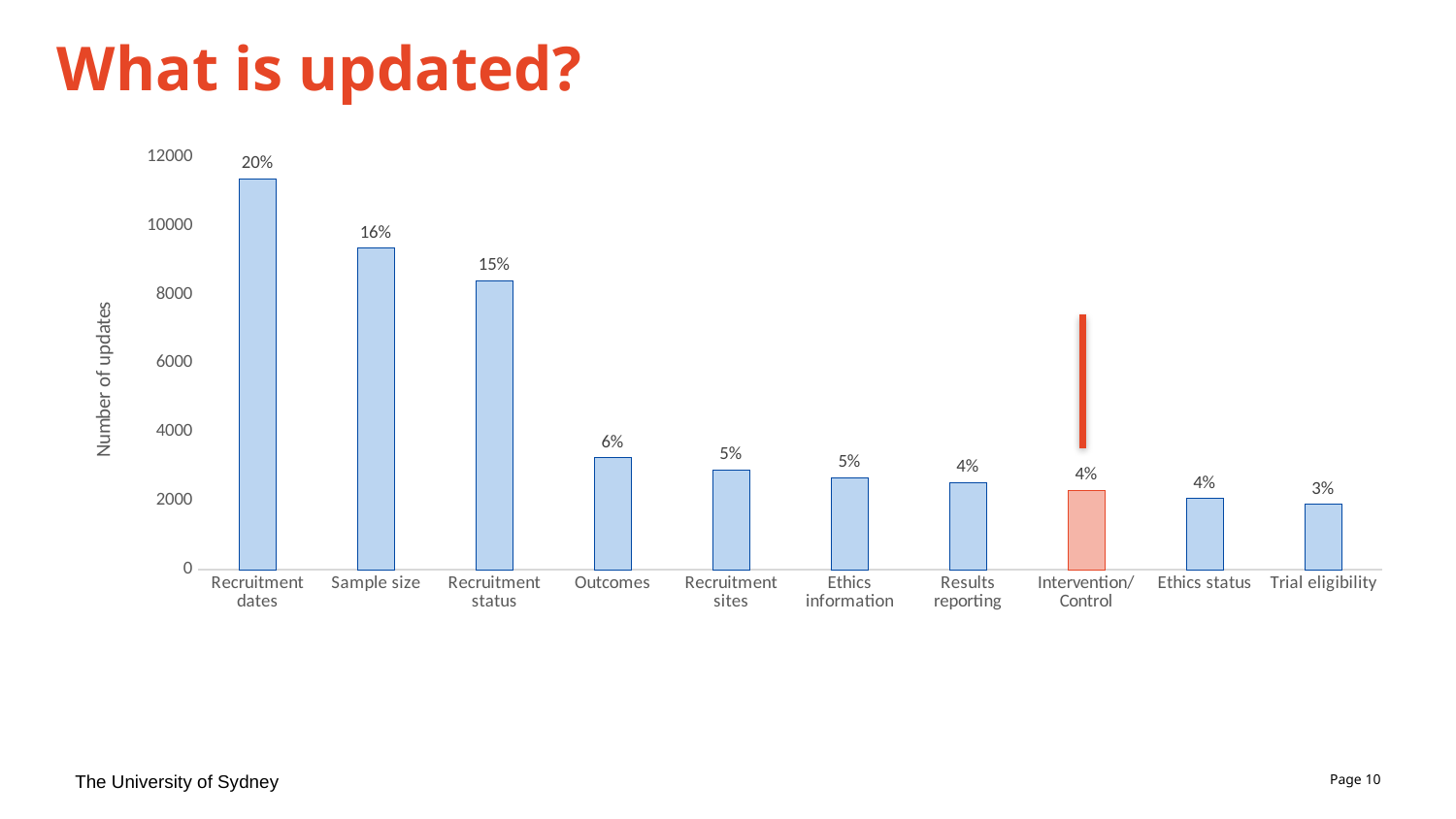
Which bar is highlighted in a different colour (orange/red) from the others? Intervention/Control What percentage label is shown above the Sample size bar? 16% Which category has the highest number of updates? Recruitment dates Is the number of updates for Recruitment dates greater or less than 10000? greater What percentage label is shown above the Outcomes bar? 6% What percentage label is shown above the Trial eligibility bar? 3% Which has more updates, Sample size or Recruitment status? Sample size How many categories are shown on the x axis? 10 What kind of chart is shown on the slide? Bar chart Which category has the lowest number of updates? Trial eligibility What percentage label is shown above the Recruitment dates bar? 20% Is the number of updates for Outcomes greater or less than 4000? less